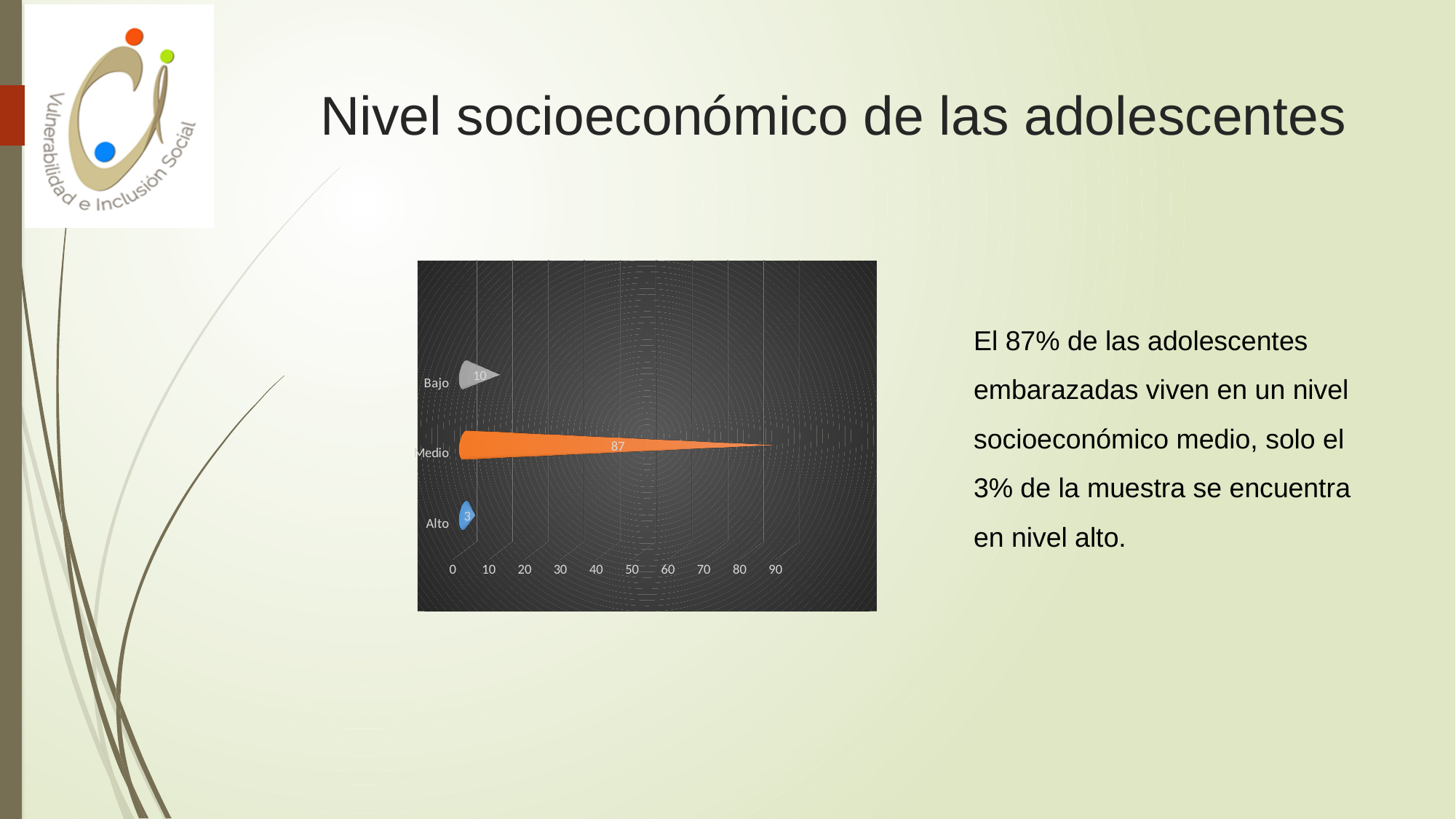
What is the difference between the values for Bajo and Alto? 7 What is the value for Bajo? 10 Which is larger, the value for Bajo or the value for Alto? Bajo What kind of chart is shown on the slide? bar chart What is the value for Medio? 87 How many categories are shown in the chart? 3 What is the difference between the values for Medio and Bajo? 77 Which category has the highest value? Medio What colour is the bar for Medio? orange Which category has the lowest value? Alto Is the value for Medio greater or less than 80? greater What is the value for Alto? 3